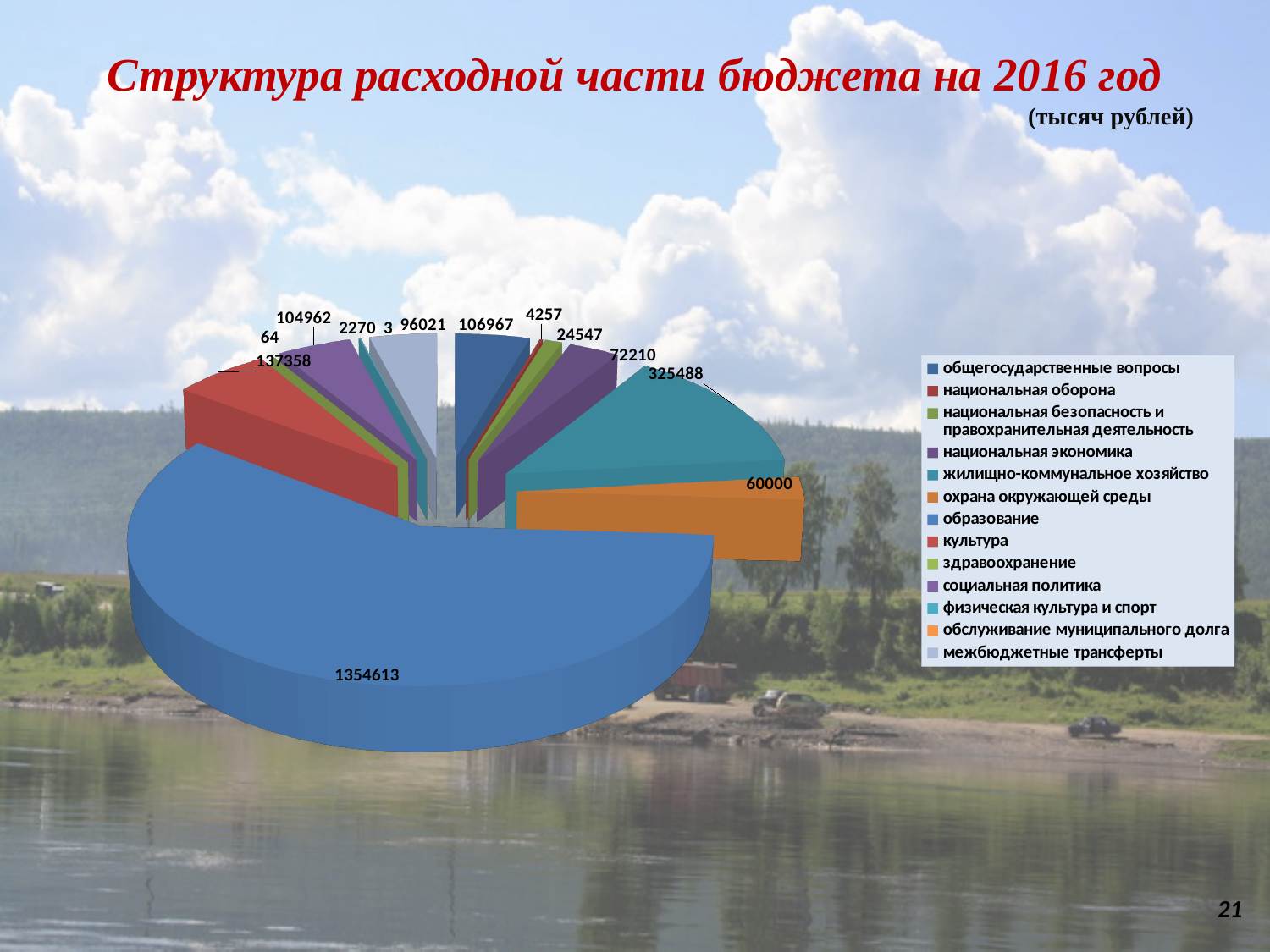
What is the value for образование? 1354613 What is the title of the slide? Структура расходной части бюджета на 2016 год What is the value for охрана окружающей среды? 60000 How many categories does the legend list? 13 What is the value for обслуживание муниципального долга? 3 What kind of chart is shown? pie chart Which category has the smallest value? обслуживание муниципального долга What is the value for культура? 137358 Which category has the largest slice? образование What is the difference between культура and общегосударственные вопросы? 30391 What is the value for жилищно-коммунальное хозяйство? 325488 Which is larger: жилищно-коммунальное хозяйство or культура? жилищно-коммунальное хозяйство